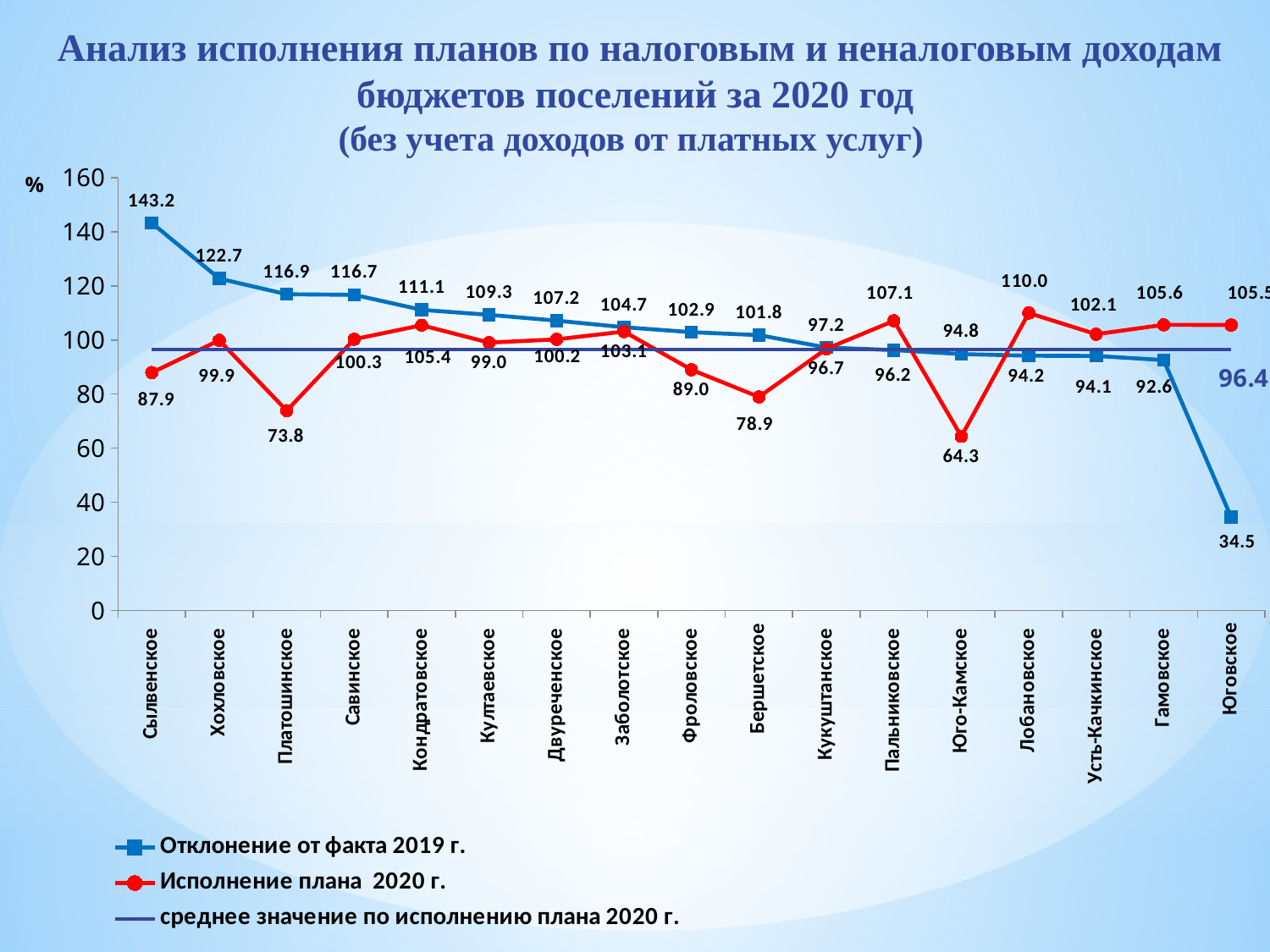
Does the 'Отклонение от факта 2019 г.' series generally rise or fall from left to right along the x axis? fall What is the value of the 'Исполнение плана 2020 г.' series for Юго-Камское? 64.3 For Бершетское, which series has the larger value: 'Отклонение от факта 2019 г.' or 'Исполнение плана 2020 г.'? Отклонение от факта 2019 г. What is the value of the 'Отклонение от факта 2019 г.' series for Сылвенское? 143.2 Which settlement has the lowest value in the 'Исполнение плана 2020 г.' series? Юго-Камское How many series does the legend list? 3 What kind of chart is shown on the slide? line chart Which settlement has the highest value in the 'Исполнение плана 2020 г.' series? Лобановское Is the 'Отклонение от факта 2019 г.' value for Хохловское greater or less than 120? greater Which settlement has the lowest value in the 'Отклонение от факта 2019 г.' series? Юговское How many settlements are shown on the x axis of the chart? 17 What is the difference between the 'Отклонение от факта 2019 г.' value and the 'Исполнение плана 2020 г.' value for Платошинское? 43.1